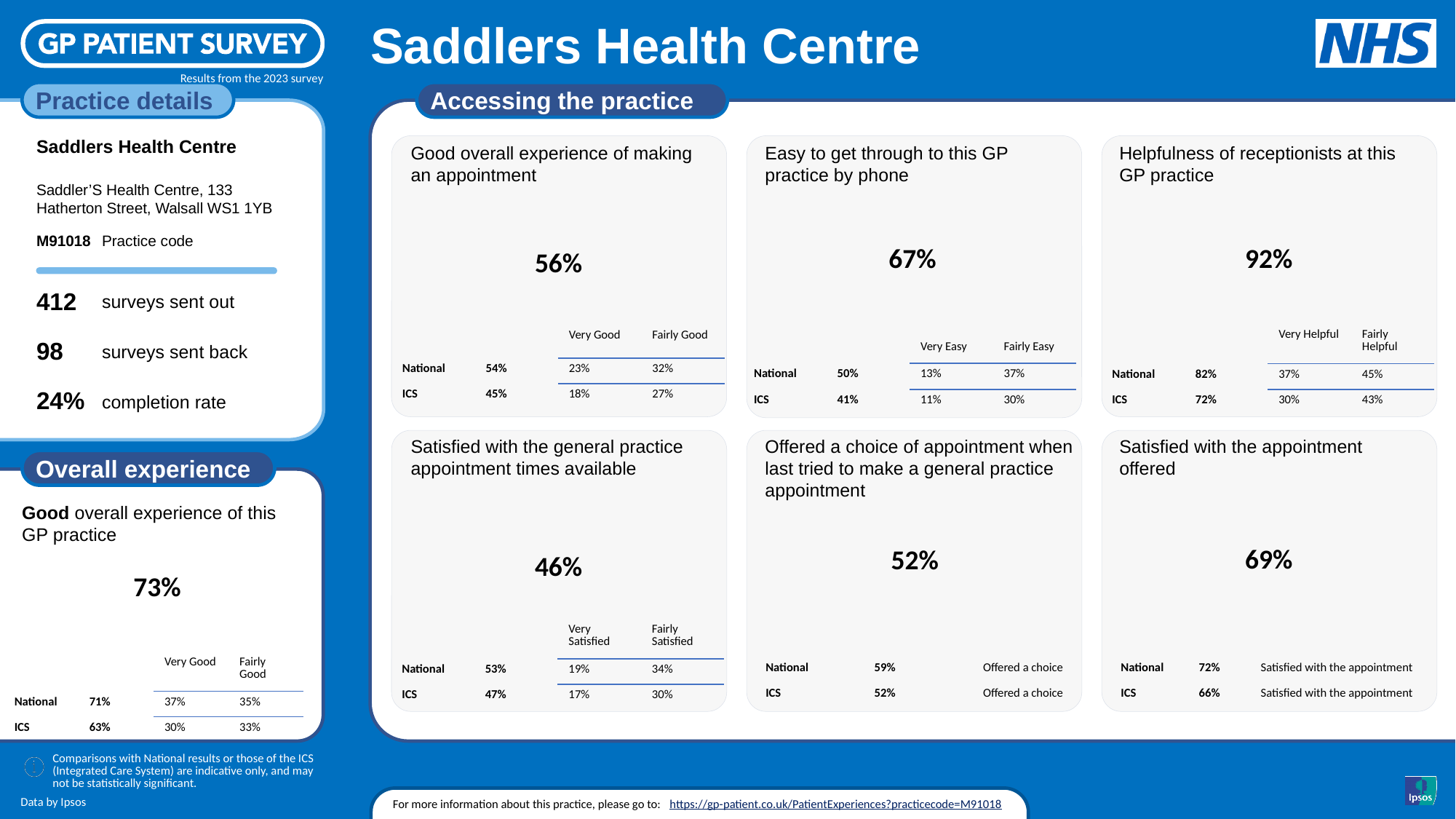
In the 'Good overall experience of this GP practice' panel under Overall experience, what is the ICS 'Very Good' percentage? 30% Across the six 'Accessing the practice' panels, which has the lowest headline percentage? Satisfied with the general practice appointment times available Across the six 'Accessing the practice' panels, which has the highest headline percentage? Helpfulness of receptionists at this GP practice In the 'Easy to get through to this GP practice by phone' panel, which is larger: the National value or the ICS value? National In the 'Good overall experience of making an appointment' panel, what is the practice's headline percentage? 56% In the 'Offered a choice of appointment when last tried to make a general practice appointment' panel, what is the practice's headline percentage? 52% In the 'Helpfulness of receptionists at this GP practice' panel, what is the ICS value? 72% In the 'Good overall experience of making an appointment' panel, what is the total of the ICS 'Very Good' and 'Fairly Good' percentages? 45% In the 'Easy to get through to this GP practice by phone' panel, what is the National value? 50% How many panels are shown under the 'Accessing the practice' heading? 6 In the 'Satisfied with the appointment offered' panel, what is the difference between the practice's headline percentage and the National value? 3% In the 'Satisfied with the general practice appointment times available' panel, what is the National 'Fairly Satisfied' percentage? 34%